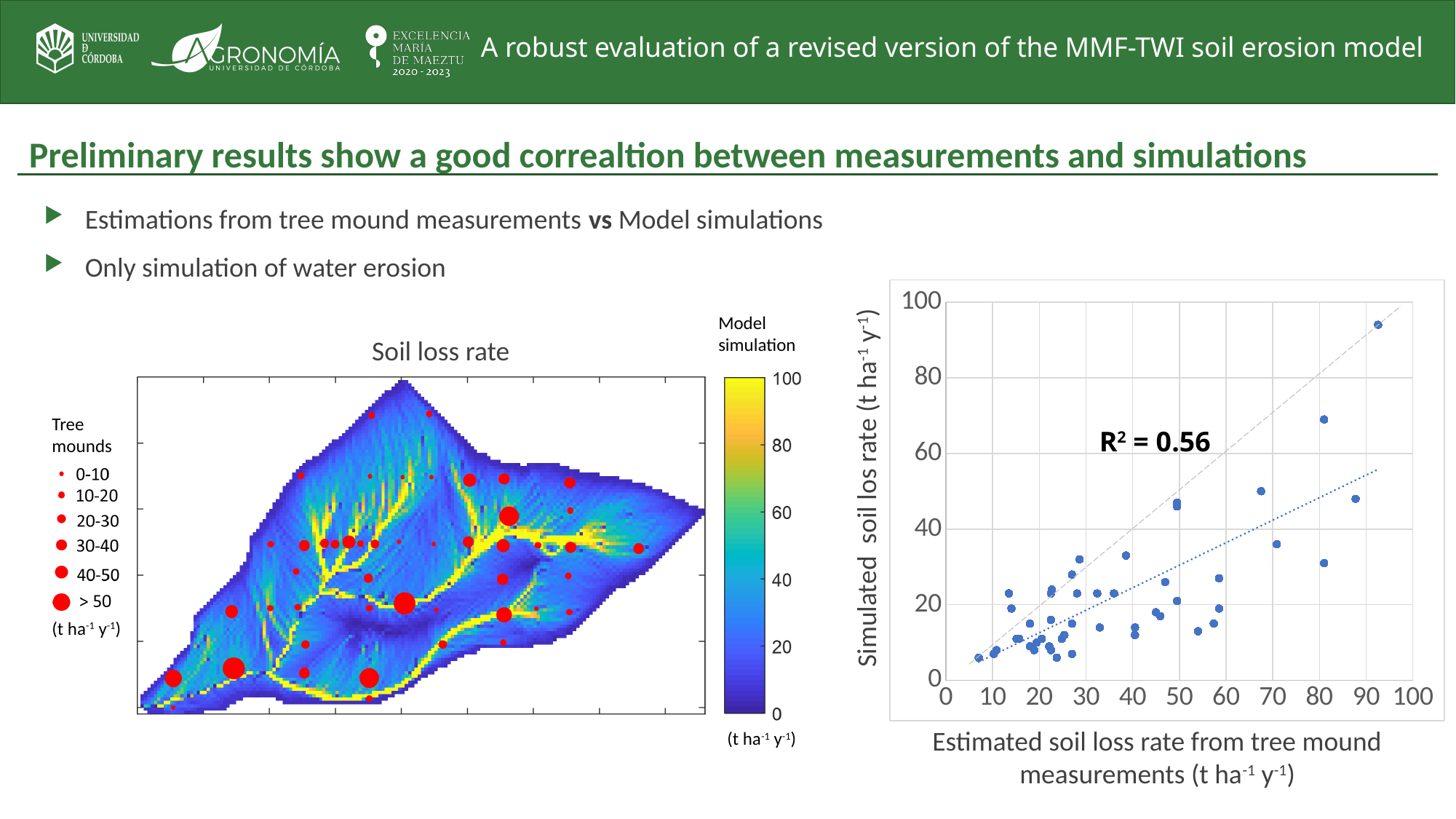
In the scatter chart, are the simulated soil loss rates of the points with an estimated rate of about 50 greater or less than 50? less What is the label of the x axis of the scatter chart? Estimated soil loss rate from tree mound measurements (t ha-1 y-1) In the scatter chart, is the simulated soil loss rate of the point with an estimated rate of about 55 greater or less than 20? less How many tree mound size classes are listed in the legend of the Soil loss rate map? 6 What R² value is printed on the scatter chart? R² = 0.56 What kind of chart is shown on the right side of the slide? scatter chart In the scatter chart, do the simulated soil loss rates generally rise or fall as the estimated soil loss rate increases? rise What is the maximum value shown on the colour bar of the Soil loss rate map? 100 What is the maximum value shown on the y axis of the scatter chart? 100 In the scatter chart, is the simulated soil loss rate of the point with the highest estimated rate (around 90) greater or less than 80? greater